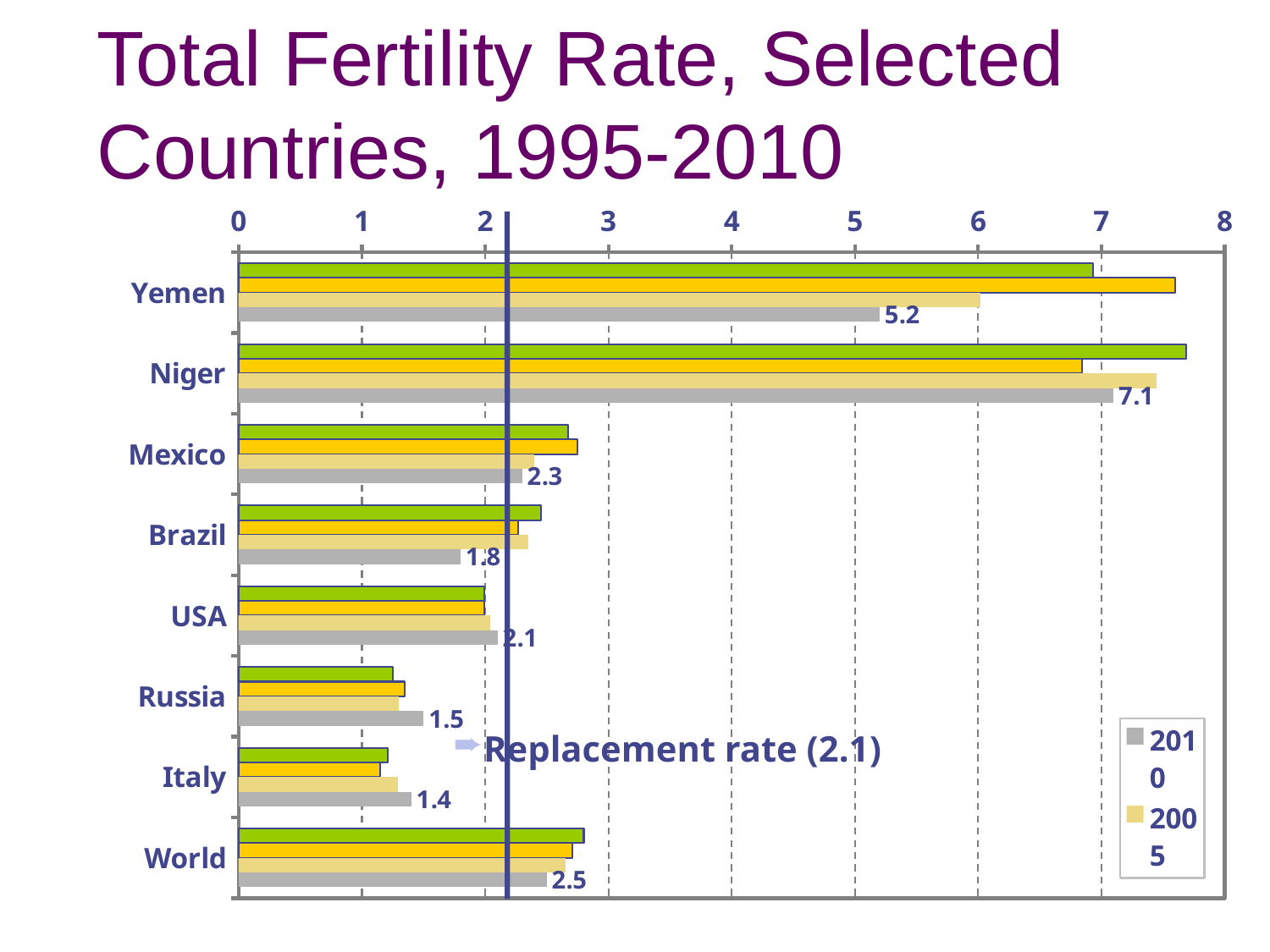
Which country has the highest 2010 total fertility rate on the chart? Niger Which country has the lowest 2010 total fertility rate on the chart? Italy What type of chart is shown on the slide? Bar chart Is the value of the green bar for Russia greater or less than 2? less Which has the larger 2010 fertility rate, Mexico or Brazil? Mexico Is the value of the green bar for Yemen greater or less than 6? greater What is the 2010 total fertility rate shown for Italy? 1.4 What is the 2010 total fertility rate shown for the World? 2.5 What is the 2010 total fertility rate shown for Niger? 7.1 What is the 2010 total fertility rate shown for Yemen? 5.2 How many countries or regions are listed on the chart's vertical axis? 8 What is the difference between the 2010 fertility rates of Niger and Yemen? 1.9